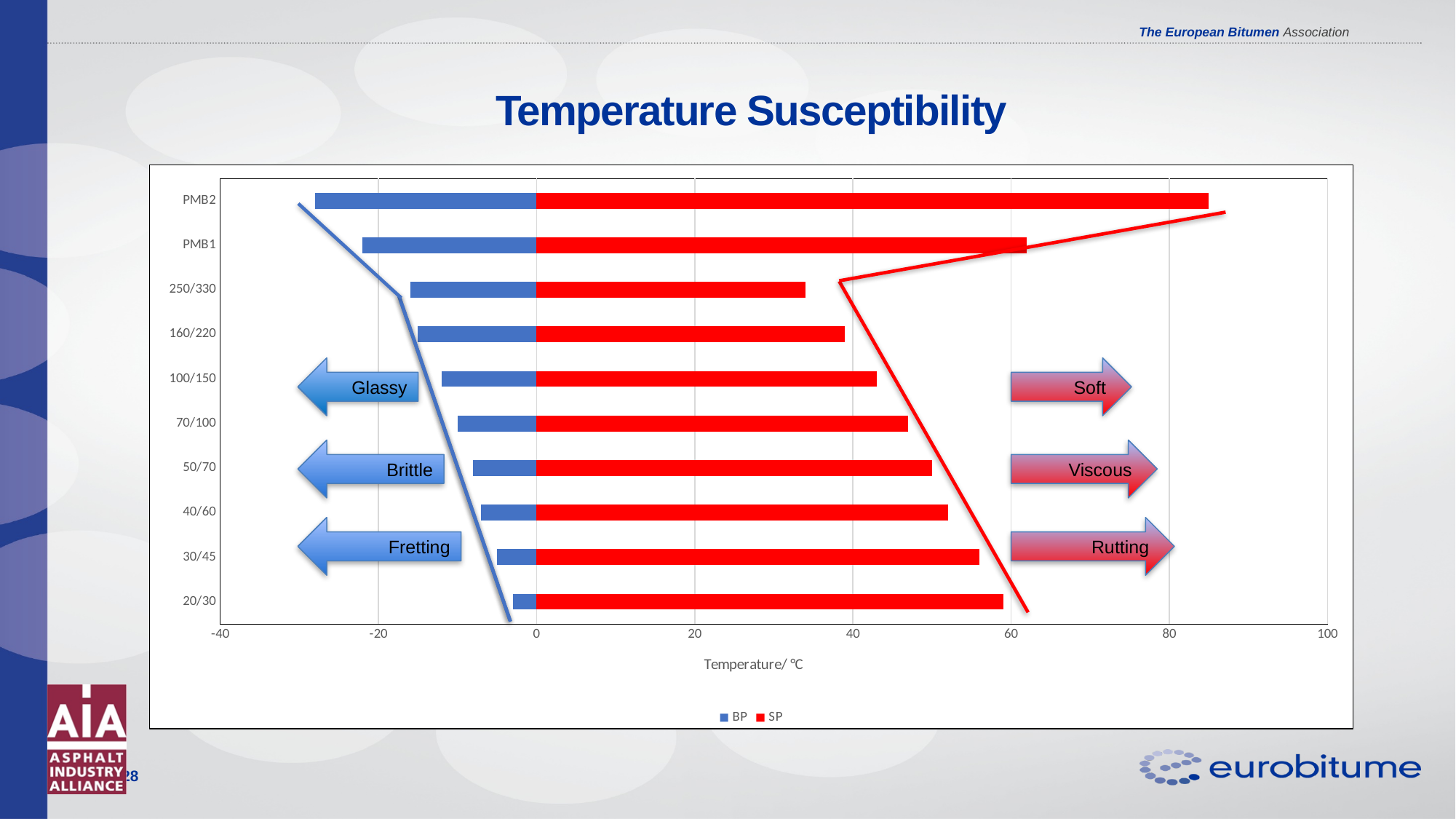
What kind of chart is shown on the slide? bar chart Moving down the categories from 250/330 to 20/30, do the SP values rise or fall? rise How many series does the chart legend list? 2 Which has the larger SP value, PMB1 or 250/330? PMB1 Which category has the highest SP value? PMB2 How many categories are listed on the vertical axis of the chart? 10 Is the SP value for PMB2 greater or less than 80? greater Which category has the most negative BP value? PMB2 Is the BP value for PMB2 greater or less than -20? less Is the SP value for 250/330 greater or less than 40? less What is the title of the horizontal axis of the chart? Temperature/ °C Which category has the lowest SP value? 250/330